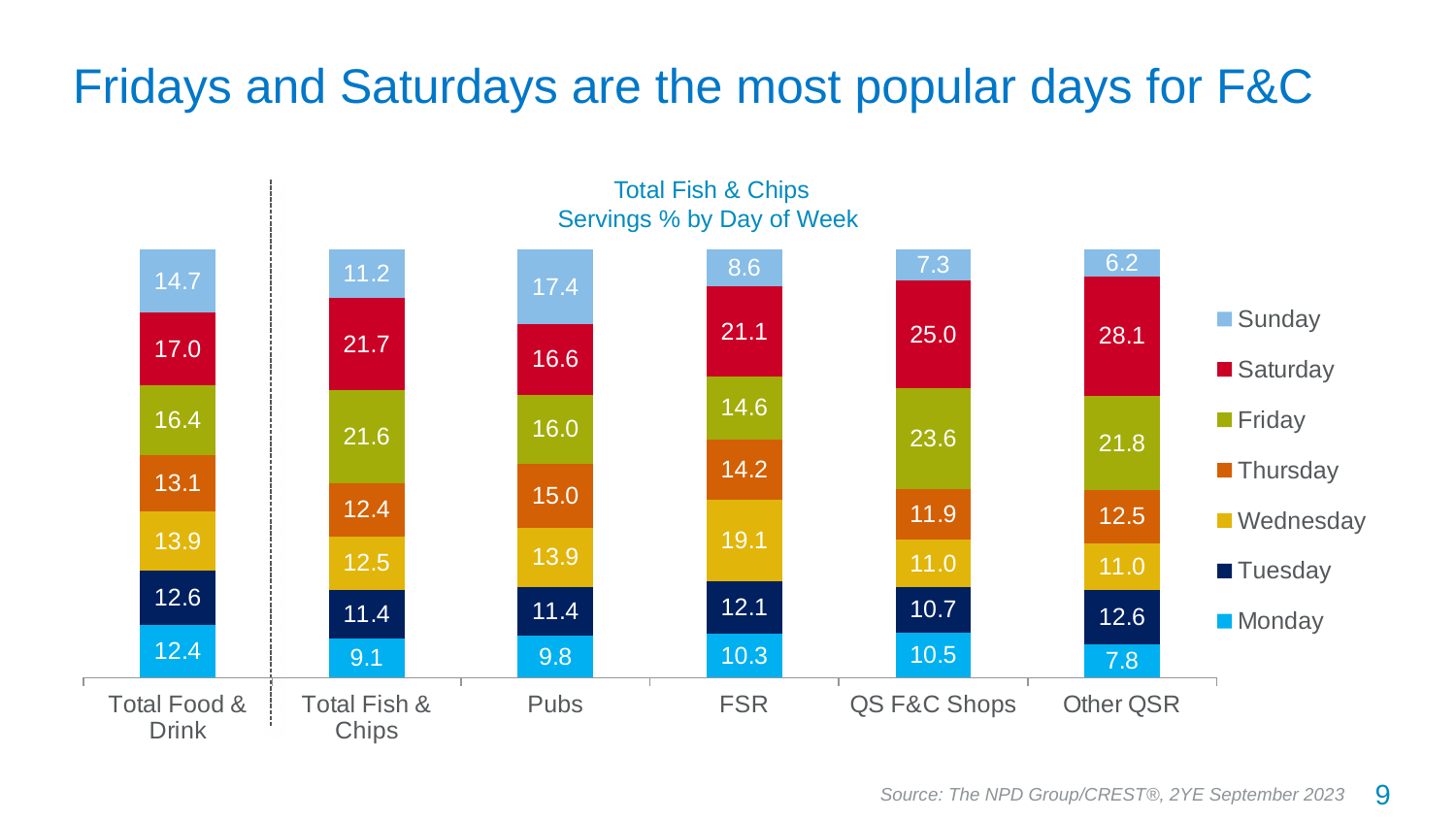
Which colour represents Friday in the legend? Green How many series does the legend list? 7 What is the difference between the Friday value for QS F&C Shops and the Friday value for Pubs? 7.6 Which is larger, the Sunday value for Pubs or the Sunday value for Total Food & Drink? Pubs Which category has the lowest Sunday value? Other QSR How many categories are shown along the x axis? 6 What is the title of the chart? Total Fish & Chips Servings % by Day of Week What is the Monday value for Total Fish & Chips? 9.1 What is the Wednesday value for FSR? 19.1 Which category has the highest Saturday value? Other QSR What is the Saturday value for Other QSR? 28.1 What kind of chart is shown on the slide? Stacked bar chart